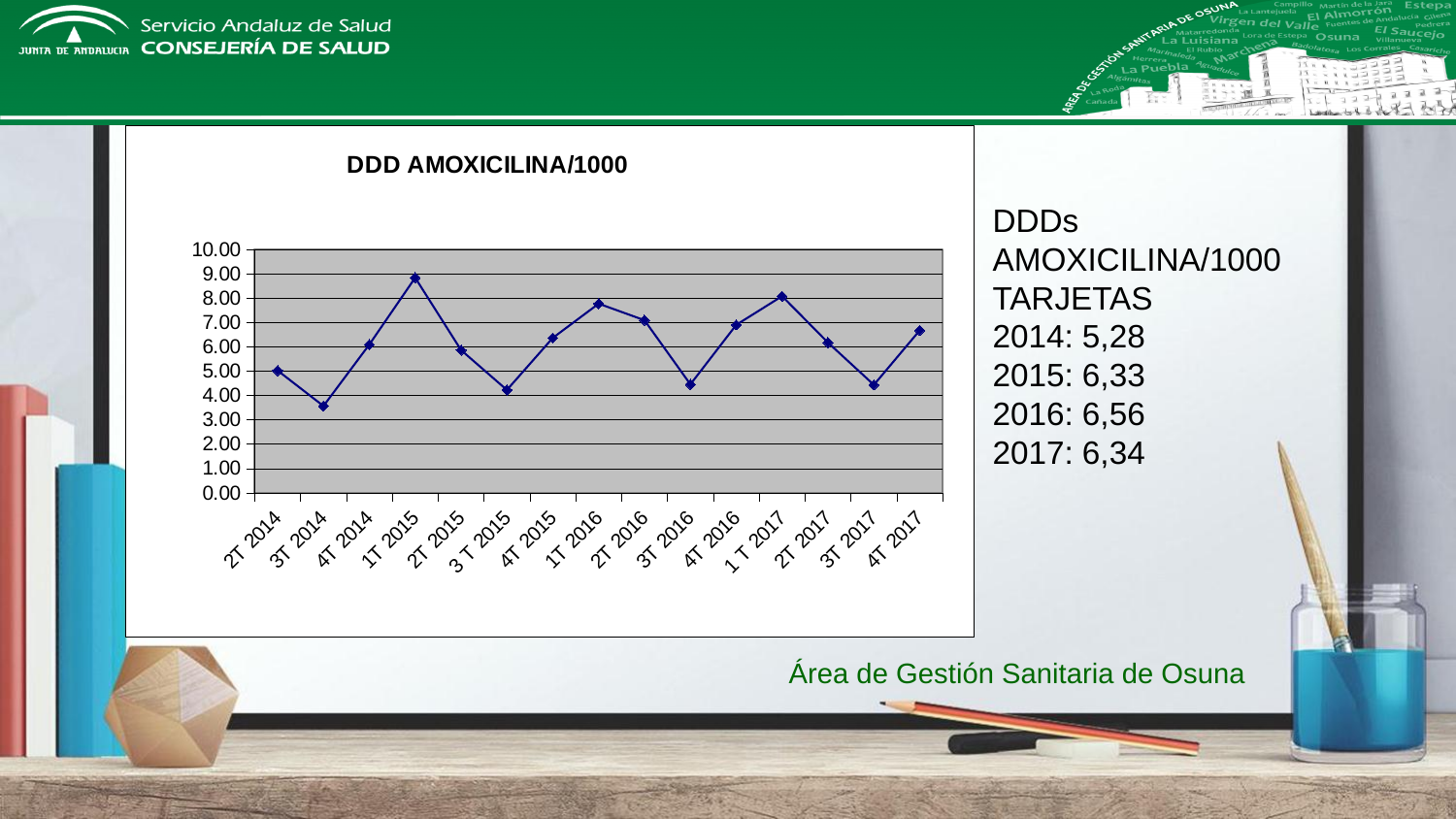
Is the value for 1T 2015 greater or less than 8.00? greater Is the value for 3T 2014 greater or less than 4.00? less Is the value for 1T 2016 greater or less than 7.00? greater Between 1T 2015 and 3T 2015, do the values rise or fall? fall What is the title of the chart? DDD AMOXICILINA/1000 How many quarterly points are plotted on the x axis of the chart? 15 Which is larger, the value for 1T 2017 or the value for 3T 2017? 1T 2017 Which quarter has the lowest value in the chart? 3T 2014 What kind of chart is shown on the slide? line chart Which is larger, the value for 1T 2015 or the value for 2T 2015? 1T 2015 Which quarter has the highest value in the chart? 1T 2015